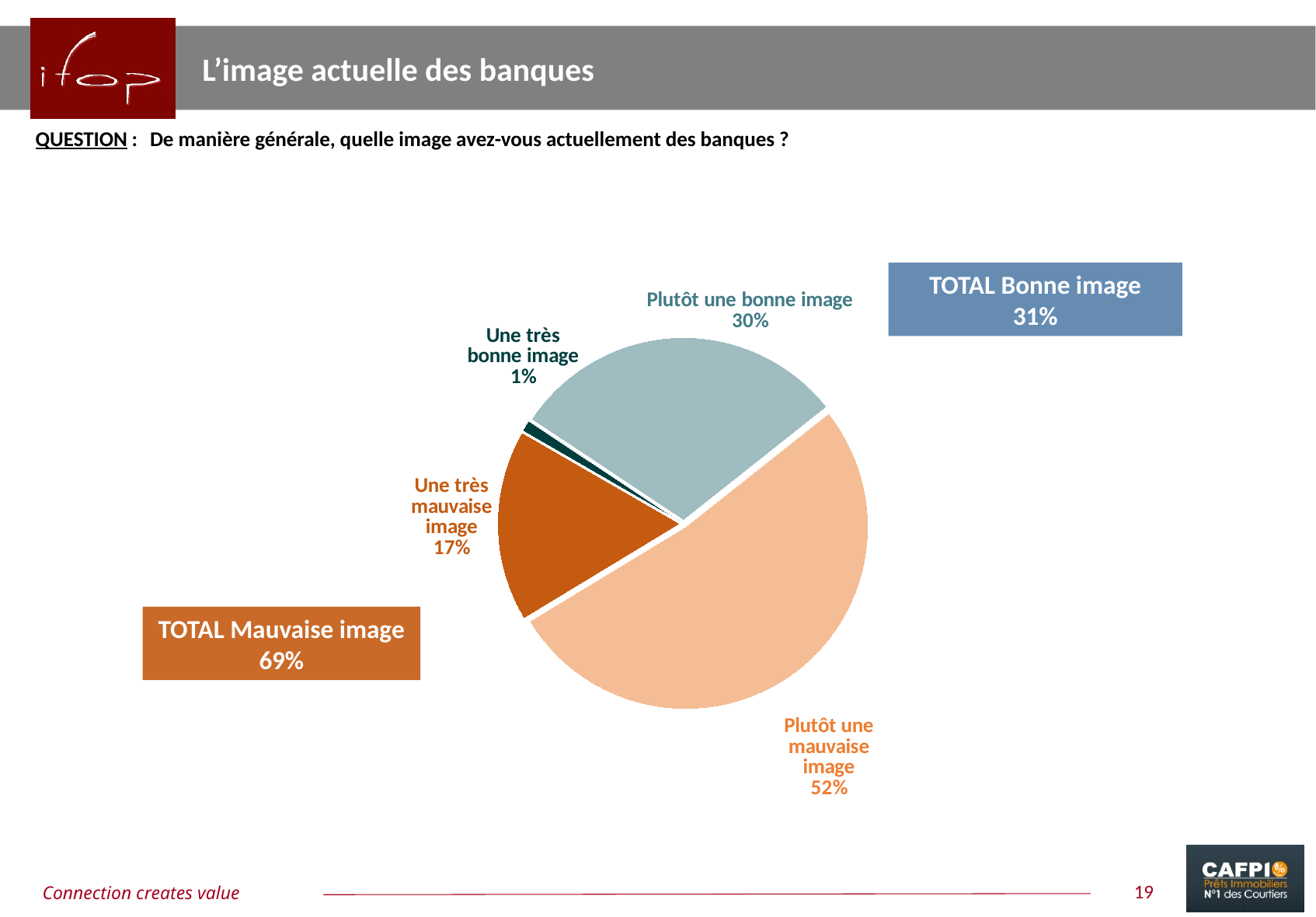
What percentage of respondents have 'Une très bonne image' of banks? 1% Which category has the smallest share of the pie? Une très bonne image What percentage of respondents have 'Une très mauvaise image' of banks? 17% What kind of chart is shown on the slide? pie chart What is the value shown in the 'TOTAL Mauvaise image' box? 69% Which category has the largest share of the pie? Plutôt une mauvaise image What percentage of respondents have 'Plutôt une mauvaise image' of banks? 52% What percentage of respondents have 'Plutôt une bonne image' of banks? 30% What is the value shown in the 'TOTAL Bonne image' box? 31% Which is larger: 'Une très mauvaise image' or 'Plutôt une bonne image'? Plutôt une bonne image How many slices does the pie chart have? 4 What is the difference between 'Plutôt une mauvaise image' and 'Plutôt une bonne image'? 22 percentage points